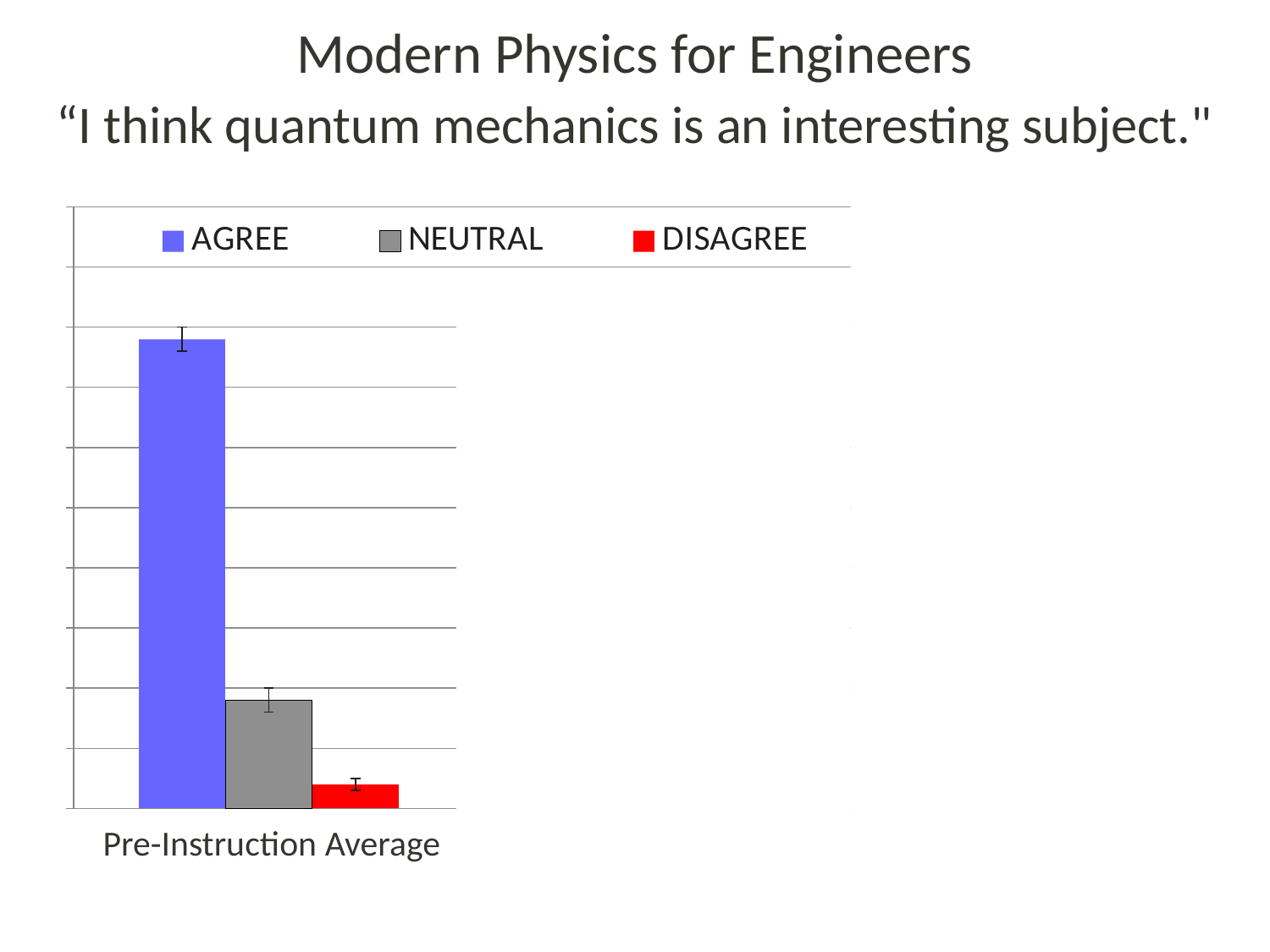
Which series has the lowest value for Pre-Instruction Average? DISAGREE What is the label of the category on the x axis? Pre-Instruction Average How many series does the legend list? 3 What kind of chart is shown on the slide? bar chart How many categories are shown on the x axis? 1 Which series has the highest value for Pre-Instruction Average? AGREE Which is larger for Pre-Instruction Average, NEUTRAL or DISAGREE? NEUTRAL What colour is the DISAGREE series in the chart? red Which is larger for Pre-Instruction Average, AGREE or NEUTRAL? AGREE